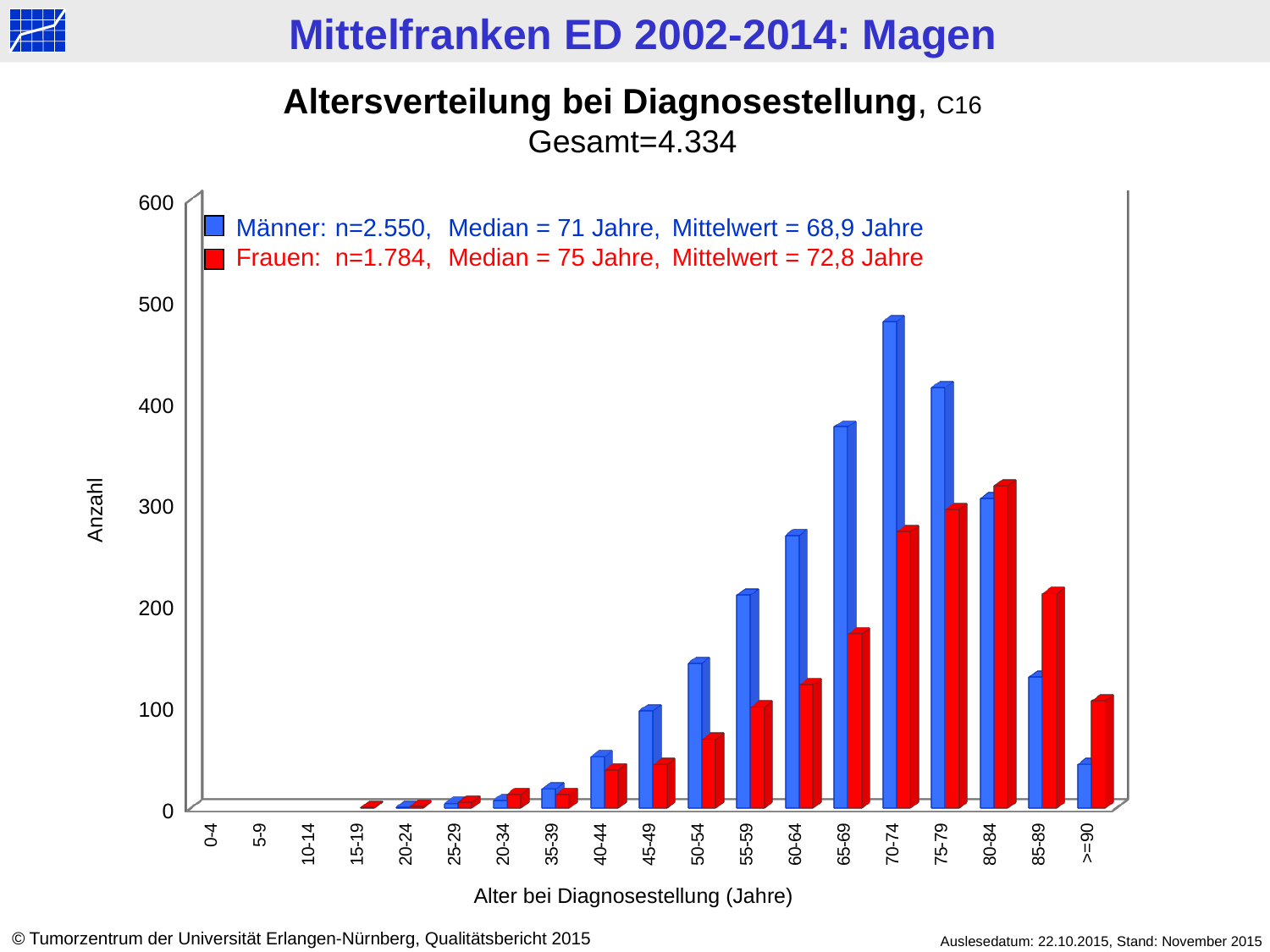
How many age-group categories are shown on the x axis? 19 According to the legend, what is the median age for Frauen? 75 Jahre What kind of chart is shown on the slide? bar chart In the 85-89 age group, which series has the larger value, Männer or Frauen? Frauen Is the value for Männer in the 85-89 age group greater or less than 100? greater Is the value for Männer in the 65-69 age group greater or less than 300? greater Is the value for Männer in the 70-74 age group greater or less than 400? greater How many series does the legend list? 2 In which age group is the value for Frauen highest? 80-84 In the 70-74 age group, which series has the larger value, Männer or Frauen? Männer In which age group is the value for Männer highest? 70-74